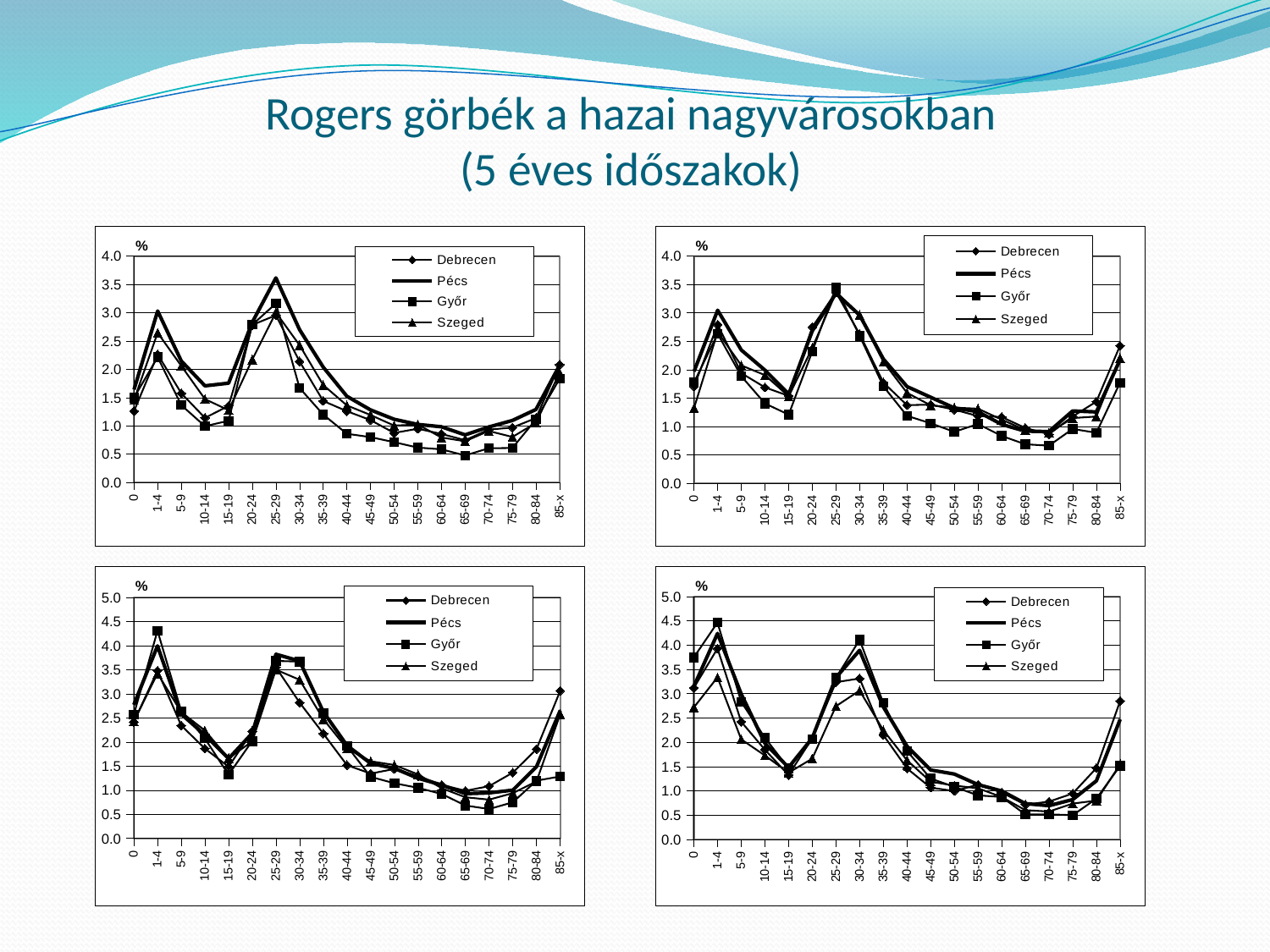
What kind of chart is the top-left chart on the slide? line chart In the bottom-right chart, which series has the highest value at 1-4? Győr In the top-right chart, is the value for Győr at 25-29 greater or less than 3.0? greater How many series does the legend of the top-right chart list? 4 In the top-left chart, is the value for Győr at 65-69 greater or less than 1.0? less In the top-right chart, is the value for Győr at 70-74 greater or less than 1.0? less Which series are listed in the legend of the bottom-right chart? Debrecen, Pécs, Győr, Szeged How many age-group categories are shown along the x axis of the bottom-left chart? 19 What is the highest value shown on the y axis of the bottom-left chart? 5.0